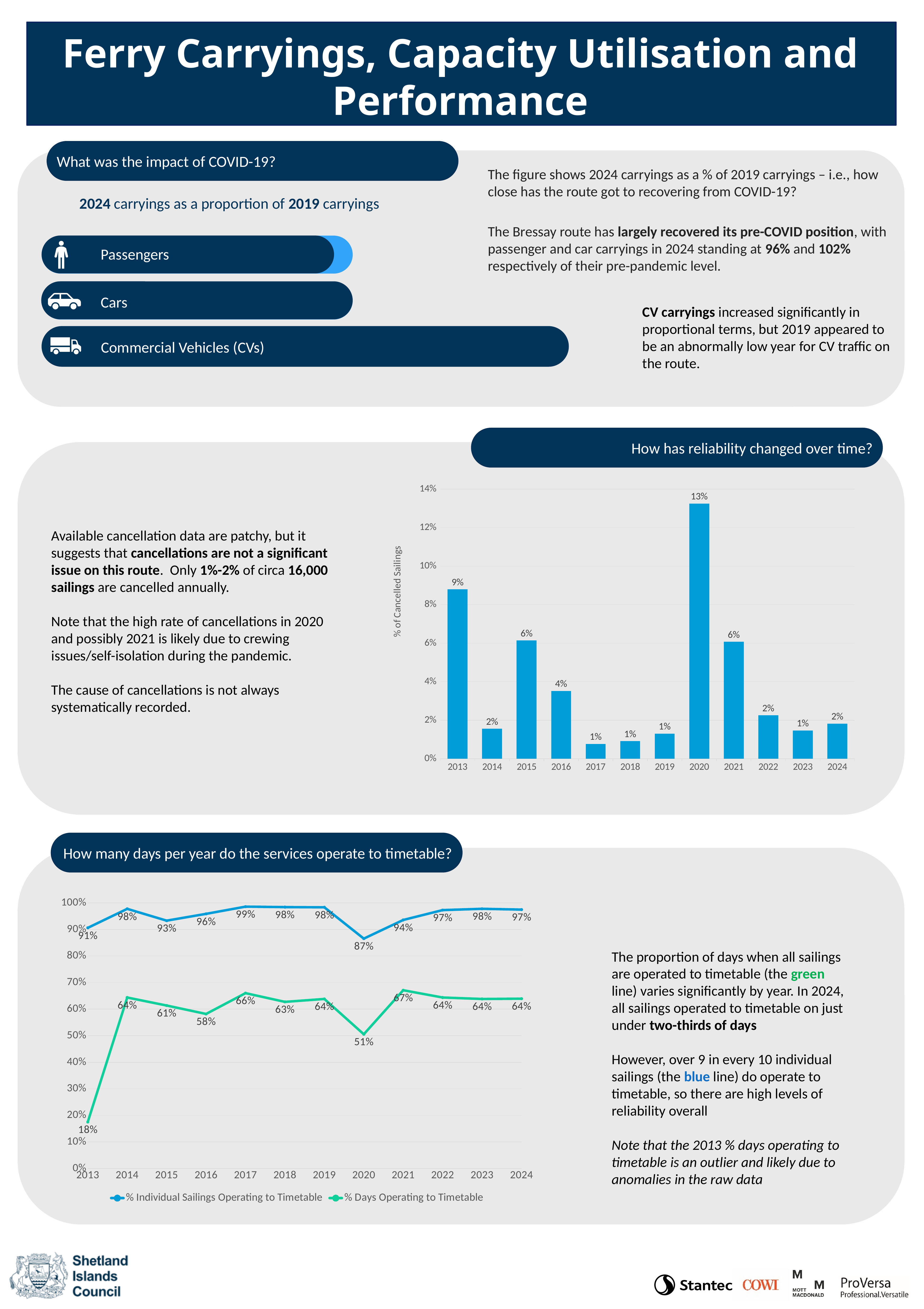
In the bottom chart about services operating to timetable, what colour is the '% Days Operating to Timetable' line? green In the '% of Cancelled Sailings' chart, how many years are shown on the x axis? 12 In the bottom chart about services operating to timetable, how many series does the legend list? 2 In the bottom chart about services operating to timetable, which year has the lowest '% Days Operating to Timetable' value? 2013 In the bottom chart about services operating to timetable, what is the '% Individual Sailings Operating to Timetable' value for 2017? 99% In the '% of Cancelled Sailings' chart, which is larger, the value for 2014 or the value for 2016? 2016 In the '% of Cancelled Sailings' chart, what kind of chart is used? bar chart What kind of chart is the bottom chart about services operating to timetable? line chart In the '% of Cancelled Sailings' chart, what is the value for 2013? 9% In the '% of Cancelled Sailings' chart, what is the difference between the 2020 value and the 2021 value? 7 percentage points In the bottom chart about services operating to timetable, what is the '% Days Operating to Timetable' value for 2020? 51% In the '% of Cancelled Sailings' chart, which year has the highest percentage of cancelled sailings? 2020